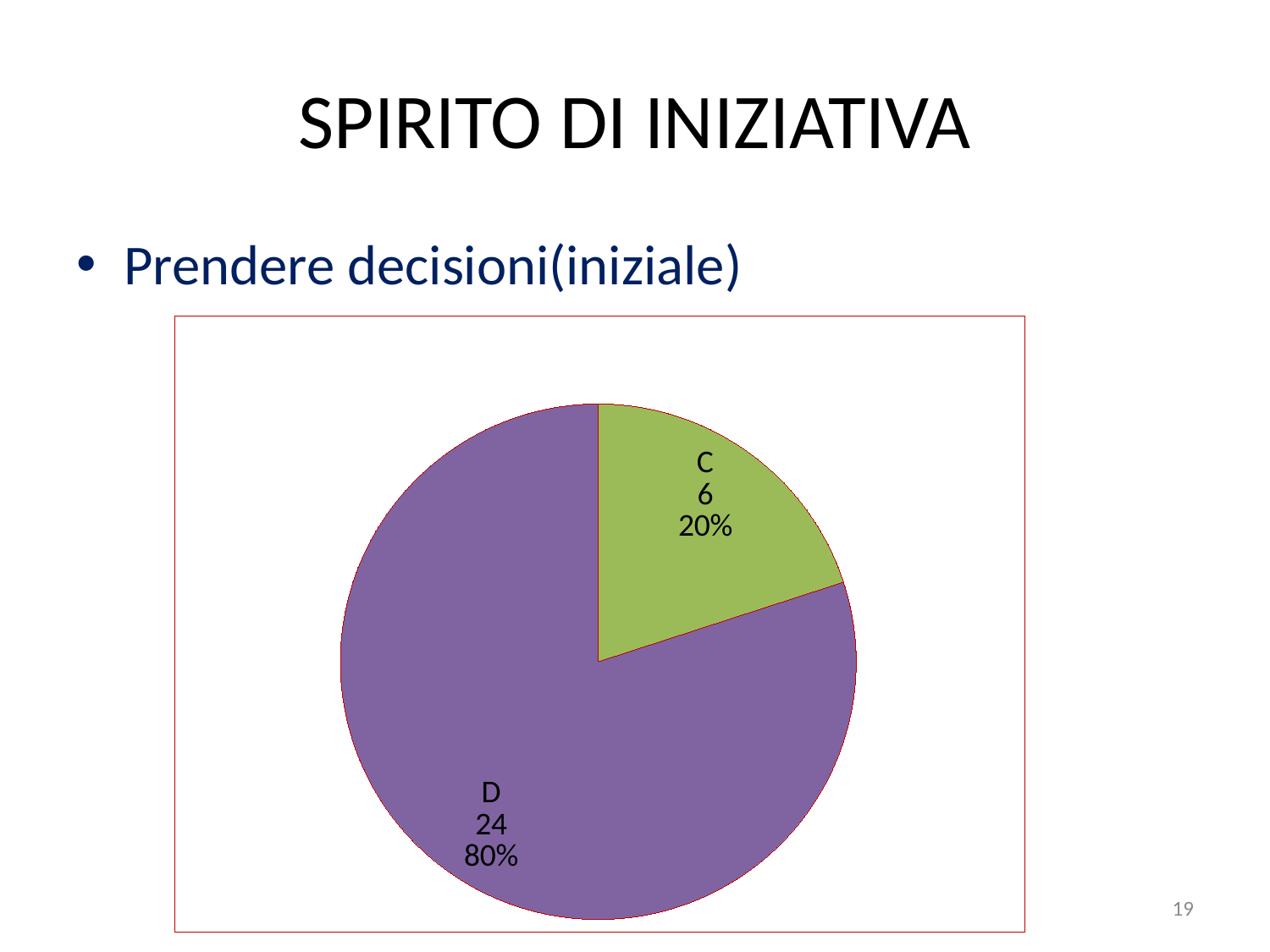
What is the value for slice C? 6 What is the value for slice D? 24 Which slice is the smallest? C What is the total of the values shown in the pie chart? 30 What is the difference between the values of D and C? 18 What share of the pie does slice D represent? 80% What kind of chart is shown on the slide? pie chart What share of the pie does slice C represent? 20% What colour is the slice labelled C? green Which is larger, the value for C or the value for D? D Which slice is the largest? D How many slices does the pie chart have? 2